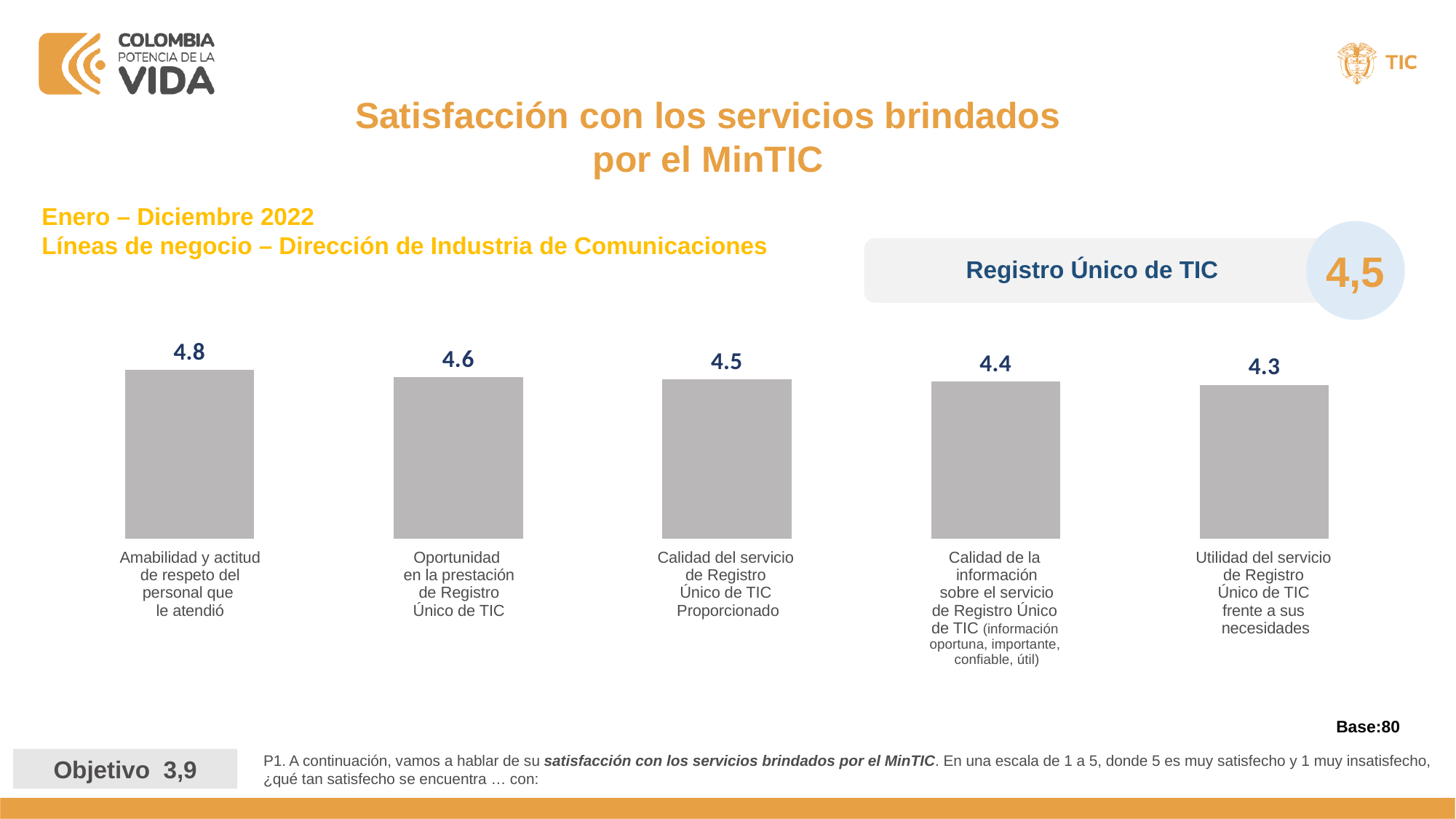
Which category has the lowest value? Utilidad del servicio de Registro Único de TIC frente a sus necesidades How many categories are shown in the chart? 5 What is the value for "Amabilidad y actitud de respeto del personal que le atendió"? 4.8 Which is larger: the value for "Oportunidad en la prestación de Registro Único de TIC" or the value for "Calidad de la información sobre el servicio de Registro Único de TIC"? Oportunidad en la prestación de Registro Único de TIC What is the value for "Utilidad del servicio de Registro Único de TIC frente a sus necesidades"? 4.3 What is the base (number of respondents) shown on the slide? 80 Which category has the highest value? Amabilidad y actitud de respeto del personal que le atendió What is the difference between the values for "Amabilidad y actitud de respeto del personal que le atendió" and "Utilidad del servicio de Registro Único de TIC frente a sus necesidades"? 0.5 What kind of chart is shown on the slide? Bar chart Do the values rise or fall from left to right across the categories? Fall What is the value for "Calidad del servicio de Registro Único de TIC Proporcionado"? 4.5 What overall score is shown for "Registro Único de TIC"? 4,5